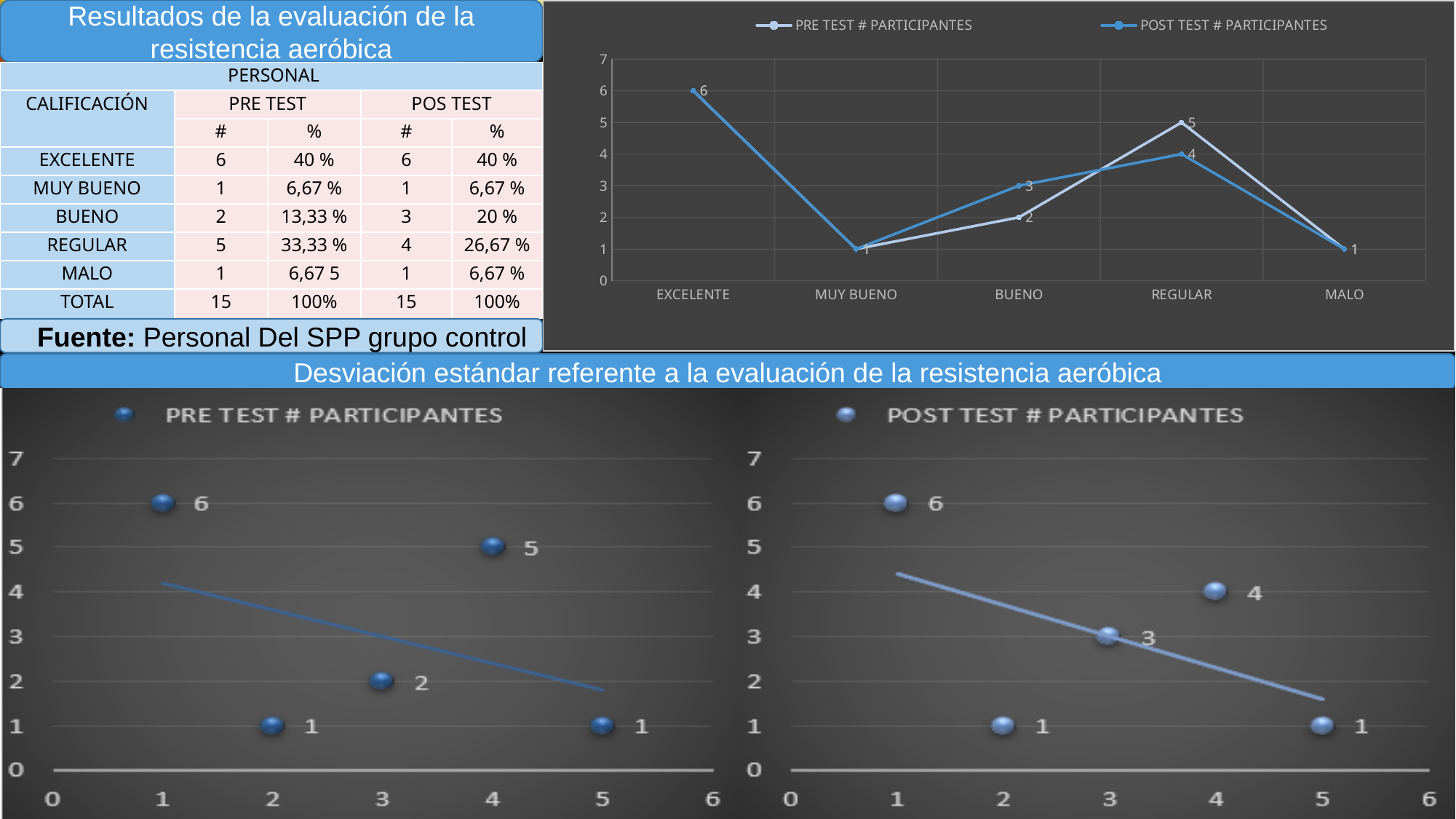
In the top-right line chart, which category has the highest PRE TEST # PARTICIPANTES value? EXCELENTE In the top-right line chart, does the POST TEST # PARTICIPANTES value rise or fall from EXCELENTE to MUY BUENO? Fall What kind of chart is the bottom-left PRE TEST # PARTICIPANTES chart? Scatter chart How many series does the legend of the top-right line chart list? 2 In the bottom-right POST TEST # PARTICIPANTES scatter chart, what is the y value of the point at x = 3? 3 In the bottom-left PRE TEST # PARTICIPANTES scatter chart, what is the y value of the point at x = 4? 5 In the top-right line chart, which is larger for BUENO: the PRE TEST value or the POST TEST value? POST TEST What kind of chart is the top-right chart? Line chart In the top-right line chart, what is the POST TEST # PARTICIPANTES value for BUENO? 3 How many categories are shown on the x axis of the top-right line chart? 5 In the top-right line chart, what is the PRE TEST # PARTICIPANTES value for REGULAR? 5 In the top-right line chart, what is the difference between the PRE TEST and POST TEST values for REGULAR? 1